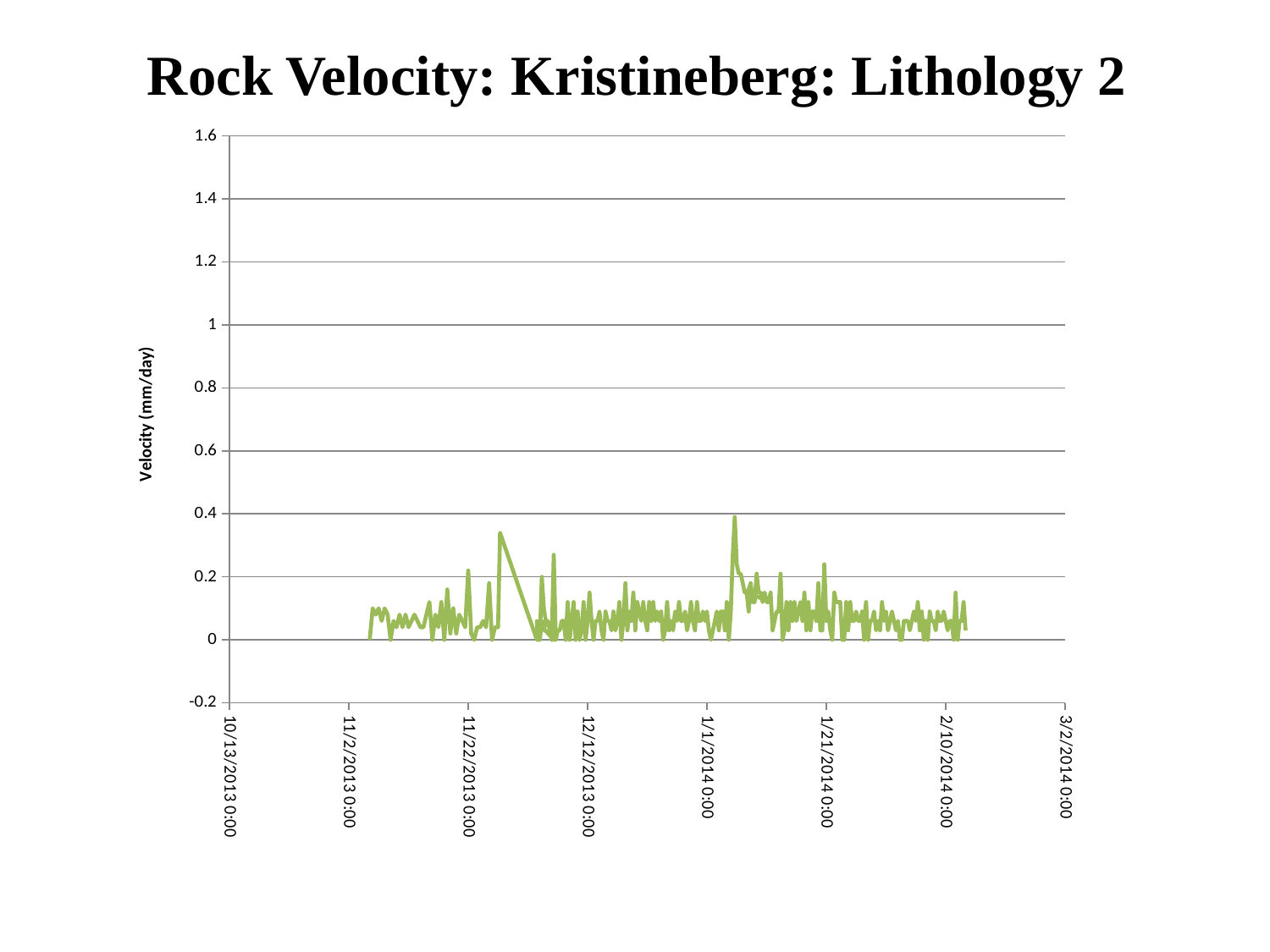
What kind of chart is shown on the slide? line chart Is the highest velocity value plotted on the chart greater or less than 1? less Is the highest velocity value plotted on the chart greater or less than 0.6? less What is the label on the vertical axis of the chart? Velocity (mm/day) Is the velocity value at 2/10/2014 greater or less than 0.2? less What is the title of the chart? Rock Velocity: Kristineberg: Lithology 2